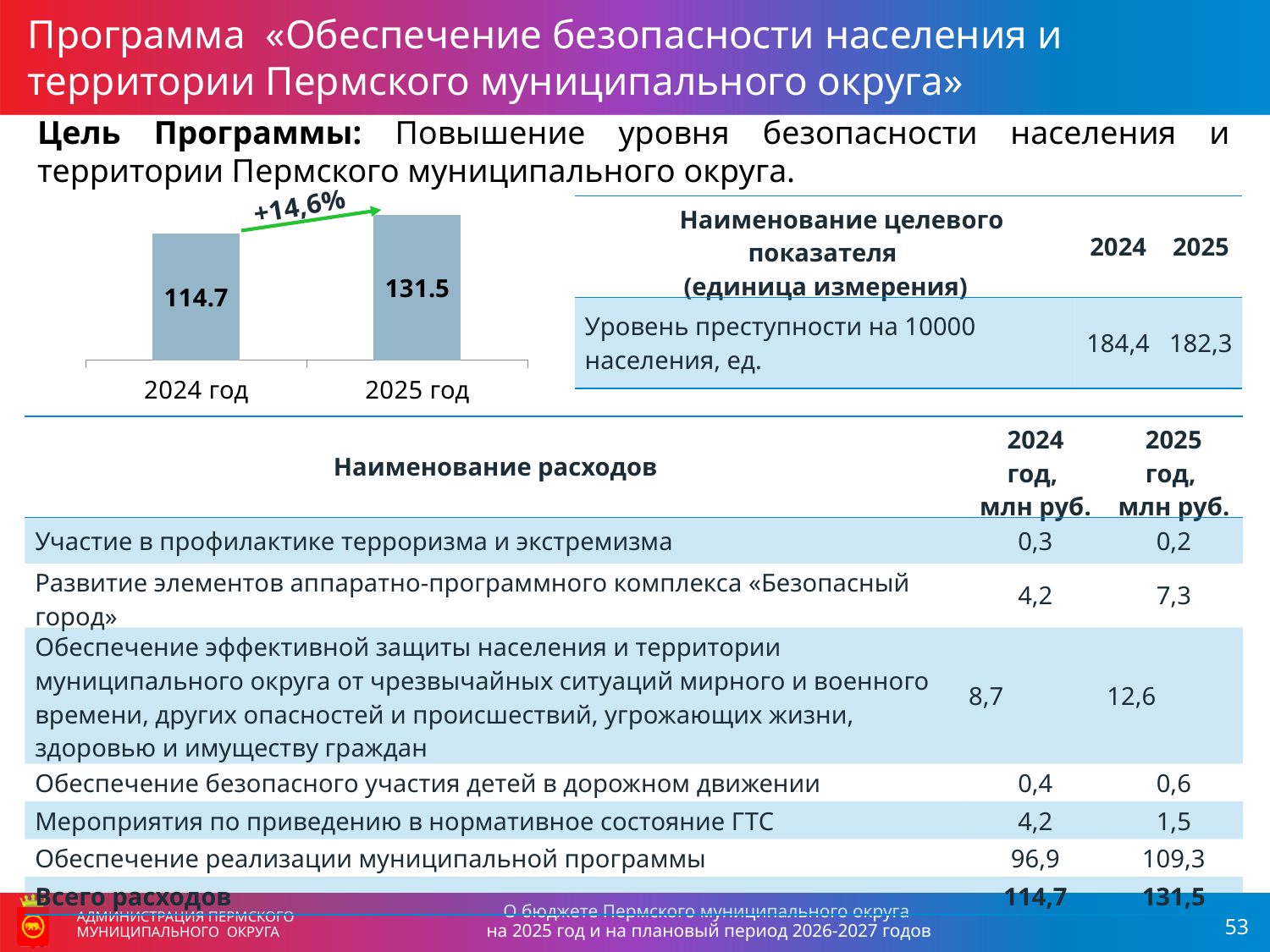
Which year has the higher bar in the chart? 2025 год Is the value for 2025 год larger or smaller than the value for 2024 год? larger How many bars are plotted in the chart? 2 What is the value shown for 2025 год in the bar chart? 131.5 What colour are the bars in the chart? blue-grey Do the values in the chart rise or fall from 2024 год to 2025 год? rise What is the difference between the 2025 год and 2024 год values in the bar chart? 16.8 What percentage change is annotated above the bars in the chart? +14,6% What is the value shown for 2024 год in the bar chart? 114.7 What kind of chart is shown on the slide? bar chart Which year has the lower bar in the chart? 2024 год